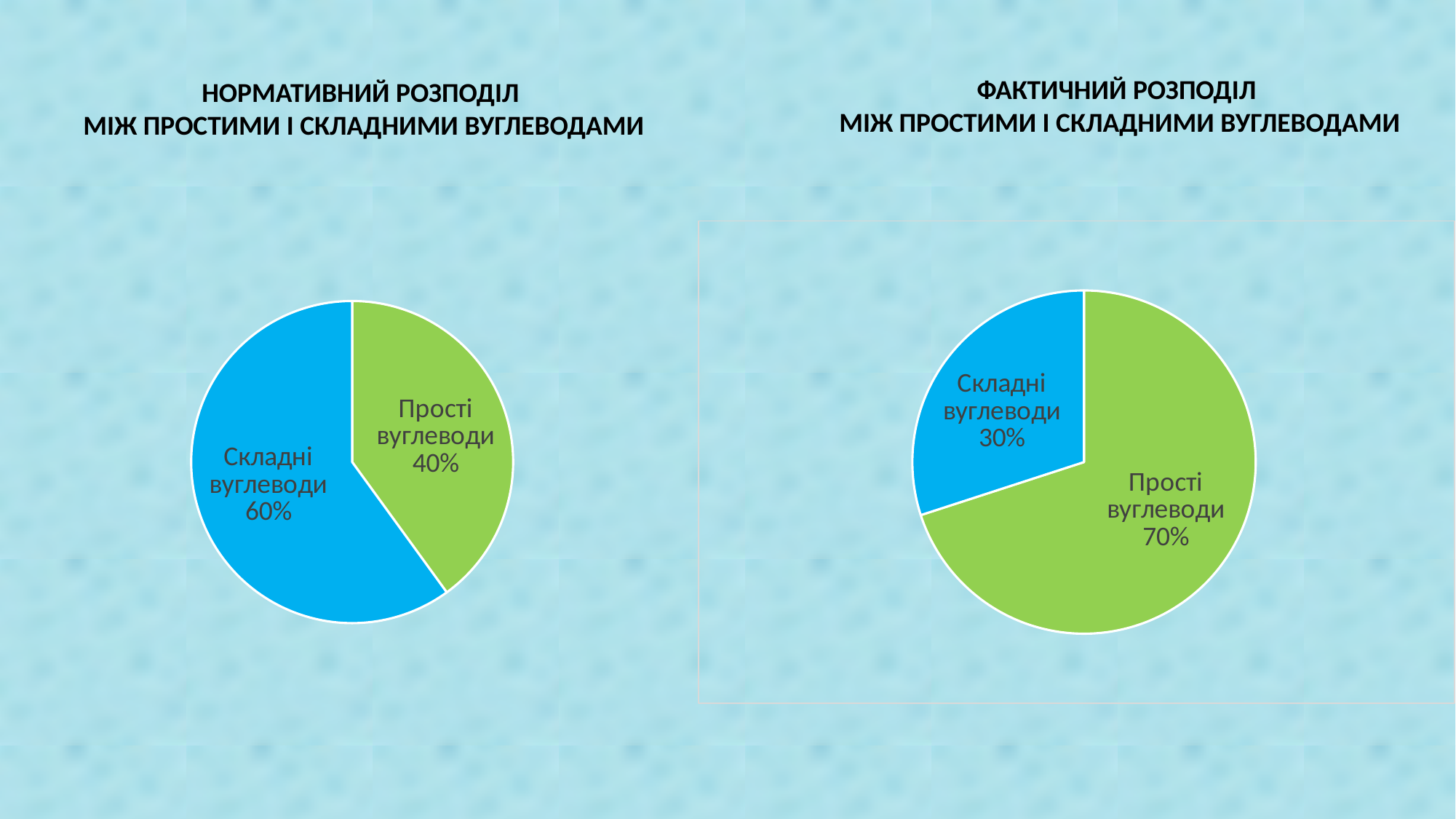
In the left chart (Нормативний розподіл), what share is Складні вуглеводи? 60% What type of chart is the right chart (Фактичний розподіл)? Pie chart In the left chart (Нормативний розподіл), what share is Прості вуглеводи? 40% In the right chart (Фактичний розподіл), which slice is the smallest? Складні вуглеводи In the left chart (Нормативний розподіл), what colour is the Складні вуглеводи slice? Blue How many slices does the left chart (Нормативний розподіл) have? 2 In the right chart (Фактичний розподіл), what is the difference between the Прості вуглеводи and Складні вуглеводи shares? 40% In the left chart (Нормативний розподіл), which slice is the largest? Складні вуглеводи In the left chart (Нормативний розподіл), what is the difference between the Складні вуглеводи and Прості вуглеводи shares? 20% In the right chart (Фактичний розподіл), what share is Складні вуглеводи? 30% In the right chart (Фактичний розподіл), what share is Прості вуглеводи? 70% In the right chart (Фактичний розподіл), which is larger: Прості вуглеводи or Складні вуглеводи? Прості вуглеводи